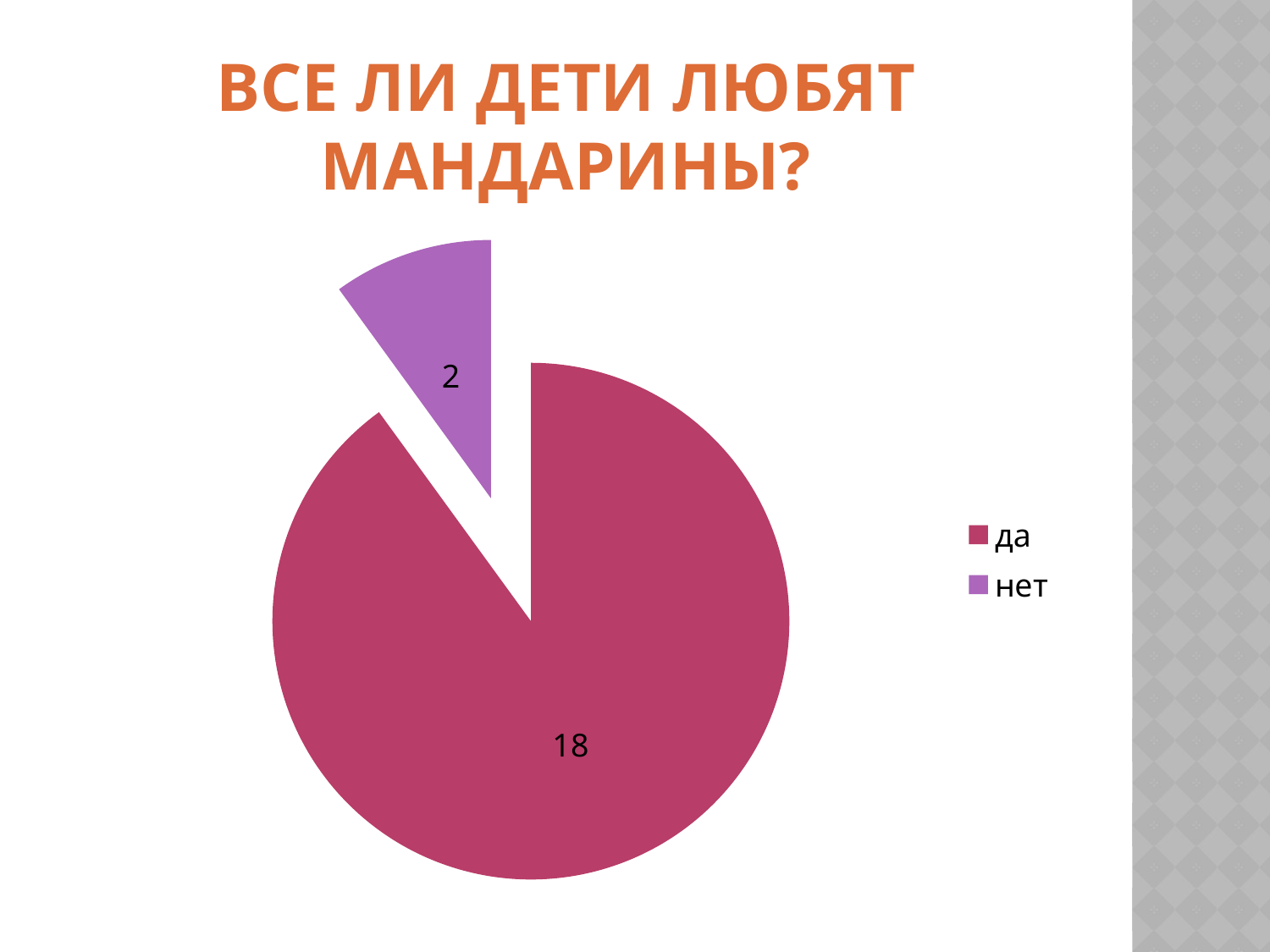
What is the difference between the values for "да" and "нет"? 16 How many slices does the pie chart have? 2 Which category has the smallest slice? нет What kind of chart is shown on the slide? pie chart What is the total of all slices in the pie chart? 20 How many entries does the legend list? 2 What is the value for "да"? 18 What is the value for "нет"? 2 What share of the pie does the "да" slice represent? 90% Which category has the largest slice? да What colour is the "нет" slice? purple Which is larger, the value for "да" or the value for "нет"? да